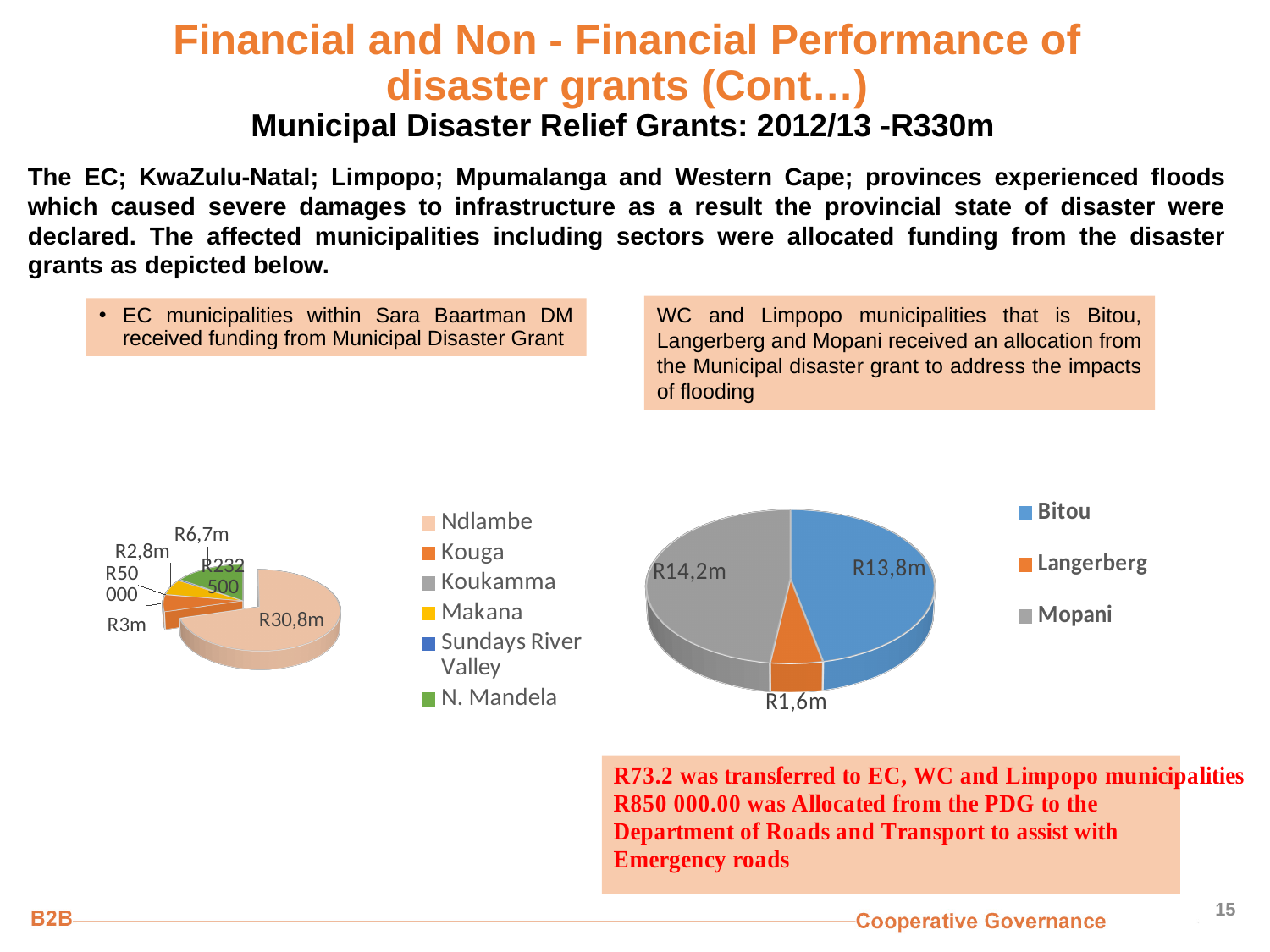
In the right pie chart, what value is shown for Mopani? R14,2m How many municipalities does the legend of the left pie chart list? 6 In the right pie chart, what value is shown for Langerberg? R1,6m In the right pie chart, what is the difference between the values for Bitou and Langerberg? R12,2m How many municipalities does the legend of the right pie chart list? 3 In the right pie chart, which is larger, the value for Bitou or the value for Mopani? Mopani In the right pie chart, which municipality has the largest allocation? Mopani In the right pie chart, which municipality has the smallest allocation? Langerberg In the right pie chart, what value is shown for Bitou? R13,8m In the left pie chart, which municipality has the largest slice? Ndlambe In the left pie chart, what value is shown for Ndlambe? R30,8m What type of chart is the left chart showing the EC municipalities? pie chart